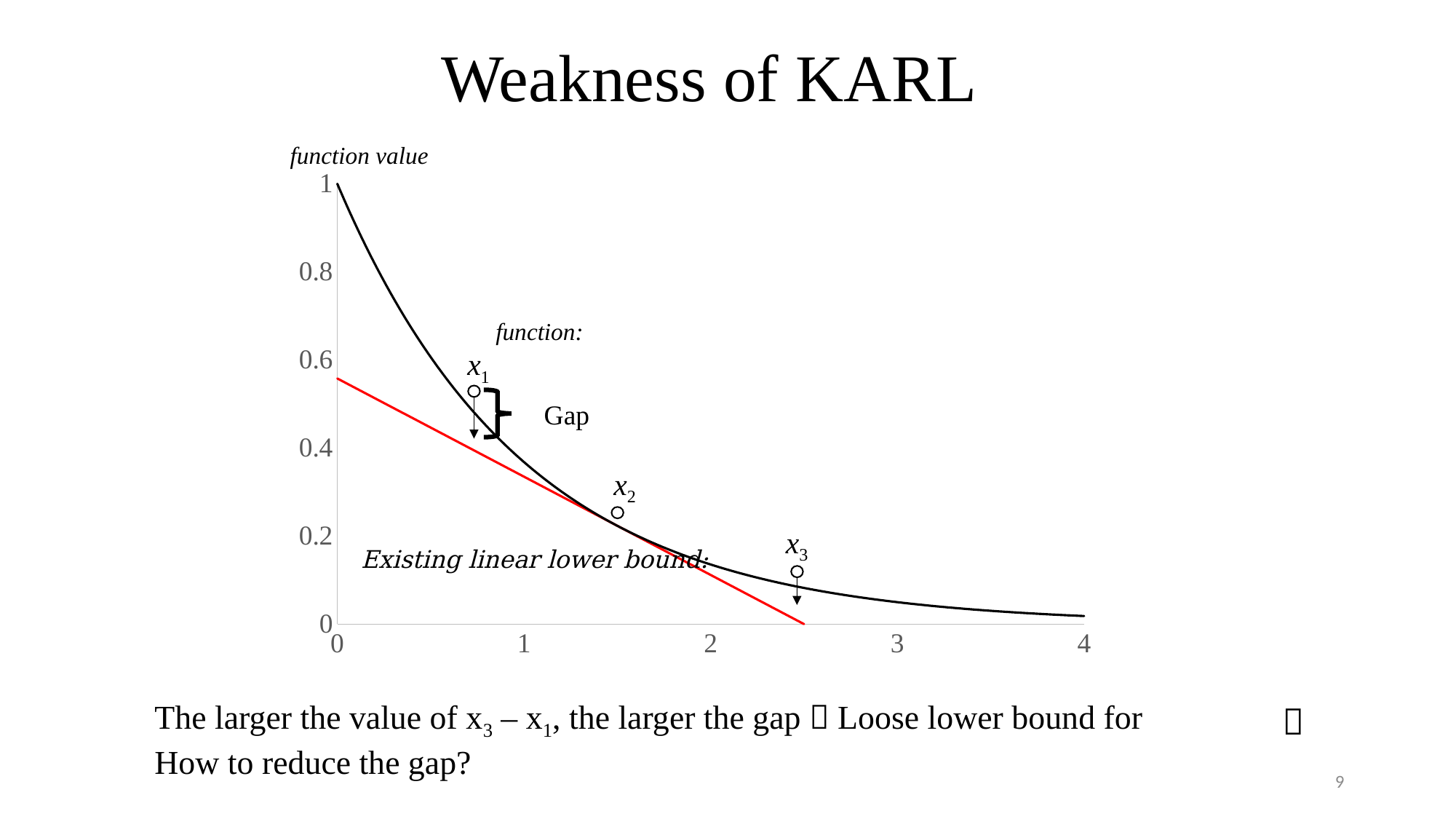
Is the x-coordinate where the red linear lower bound reaches 0 greater or less than 2? greater At the point x1, which is higher: the black function curve or the red linear lower bound? the black function curve How many labelled points (x1, x2, x3) are marked on the curve? 3 Is the function value at the point x2 greater or less than 0.4? less Is the function value at the point x3 greater or less than 0.2? less What is the largest value shown on the x axis? 4 What label is given to the vertical axis? function value Does the function value rise or fall as x increases along the x axis? fall What is the function value at x = 0, where the black curve starts? 1 What kind of chart is shown on the slide? line chart